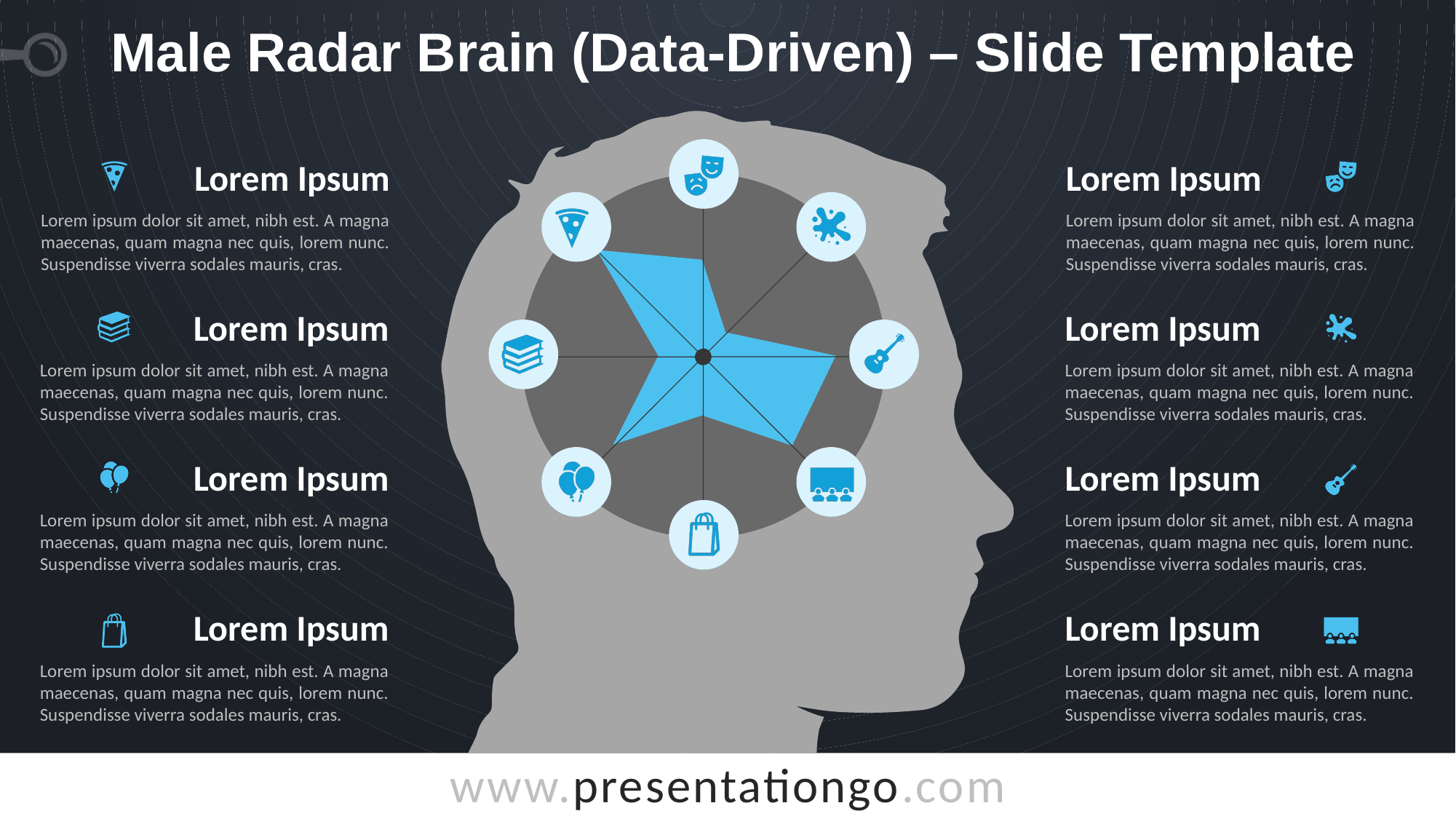
How many data series are plotted on the radar chart? 1 What colour is the filled data area of the radar chart? Blue Which is larger on the radar chart: the value on the guitar axis or the value on the paint-splash axis? Guitar axis What kind of chart is shown inside the head silhouette? Radar chart Are the radar chart's categories labelled with text or with icons? Icons Which is larger on the radar chart: the value on the pizza axis or the value on the theater-masks axis? Pizza axis How many axes (categories) does the radar chart have? 8